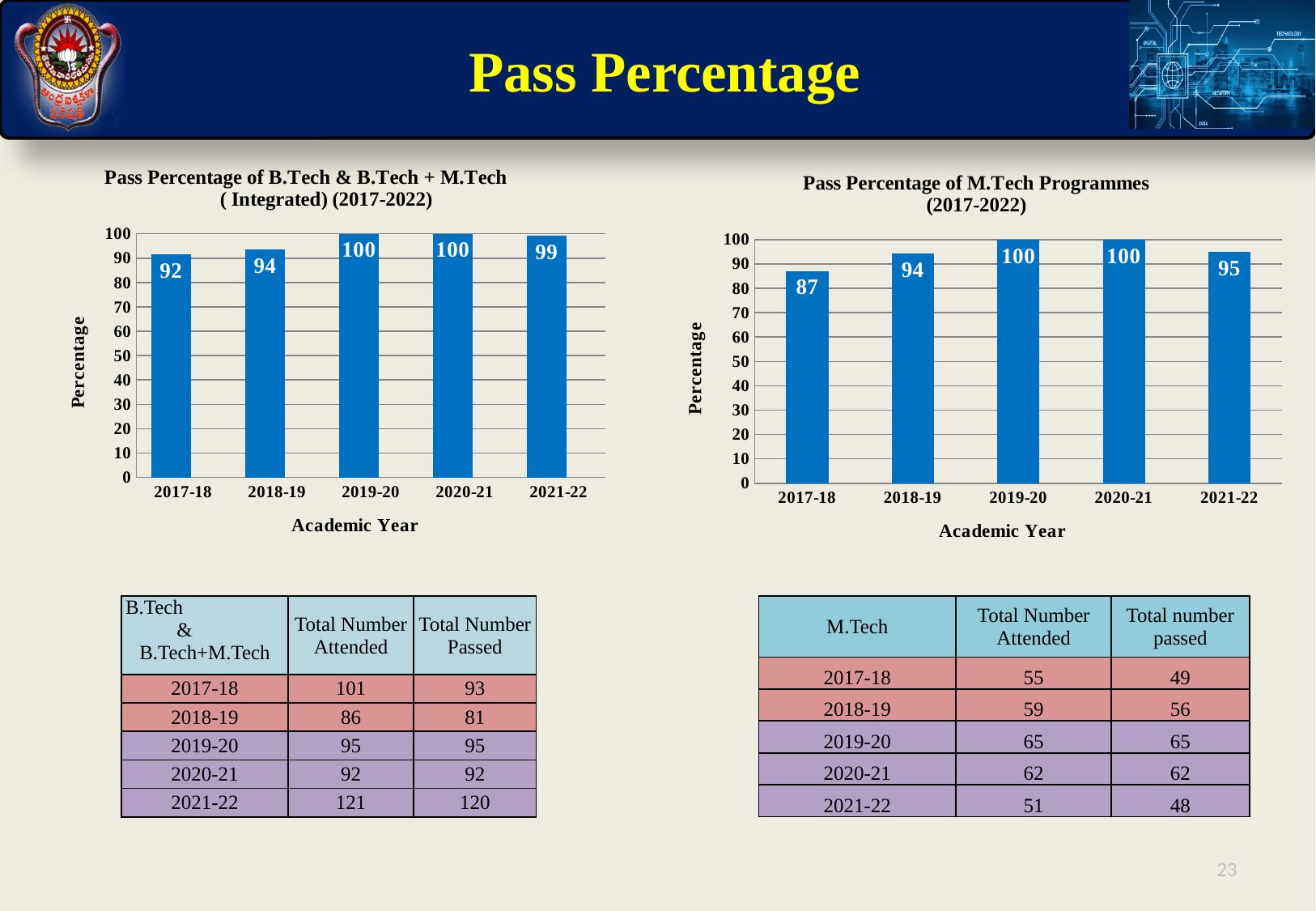
In the right chart (Pass Percentage of M.Tech Programmes), which is larger, the pass percentage for 2018-19 or for 2021-22? 2021-22 What is the label on the x axis of the right chart (Pass Percentage of M.Tech Programmes)? Academic Year In the right chart (Pass Percentage of M.Tech Programmes), what is the difference between the pass percentages for 2018-19 and 2017-18? 7 In the left chart (Pass Percentage of B.Tech & B.Tech + M.Tech (Integrated)), which academic year has the lowest pass percentage? 2017-18 In the right chart (Pass Percentage of M.Tech Programmes), which academic year has the lowest pass percentage? 2017-18 How many academic years are shown in the right chart (Pass Percentage of M.Tech Programmes)? 5 In the left chart (Pass Percentage of B.Tech & B.Tech + M.Tech (Integrated)), what is the pass percentage for 2017-18? 92 In the left chart (Pass Percentage of B.Tech & B.Tech + M.Tech (Integrated)), is the value for 2018-19 greater or less than 90? greater In the left chart (Pass Percentage of B.Tech & B.Tech + M.Tech (Integrated)), what is the difference between the pass percentages for 2019-20 and 2017-18? 8 What kind of chart is the left chart (Pass Percentage of B.Tech & B.Tech + M.Tech (Integrated))? Bar chart In the right chart (Pass Percentage of M.Tech Programmes), what is the pass percentage for 2021-22? 95 In the right chart (Pass Percentage of M.Tech Programmes), what is the pass percentage for 2017-18? 87